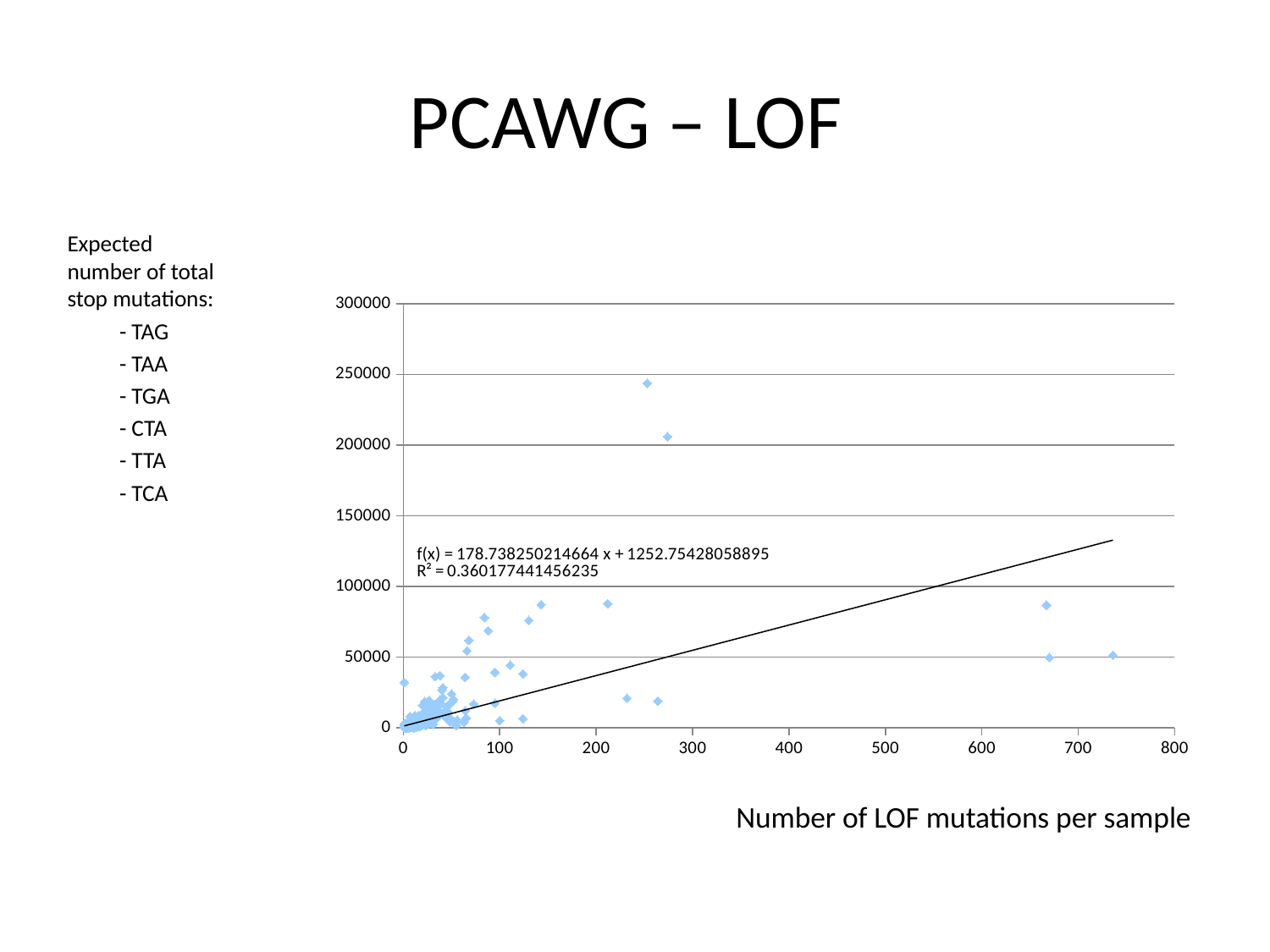
Is the highest plotted point on the chart greater or less than 200000 on the y axis? greater What is the maximum value shown on the x axis of the chart? 800 Is the highest plotted point on the chart greater or less than 250000 on the y axis? less What is the slope of the trendline equation printed on the chart? 178.738250214664 Is the x value of the rightmost plotted point greater or less than 700? greater What kind of chart is shown on the slide? scatter plot What R² value is printed on the chart for the trendline? 0.360177441456235 What is the title of the slide containing the chart? PCAWG – LOF Does the fitted trendline rise or fall as the number of LOF mutations per sample increases? rise What is the label of the x axis of the chart? Number of LOF mutations per sample